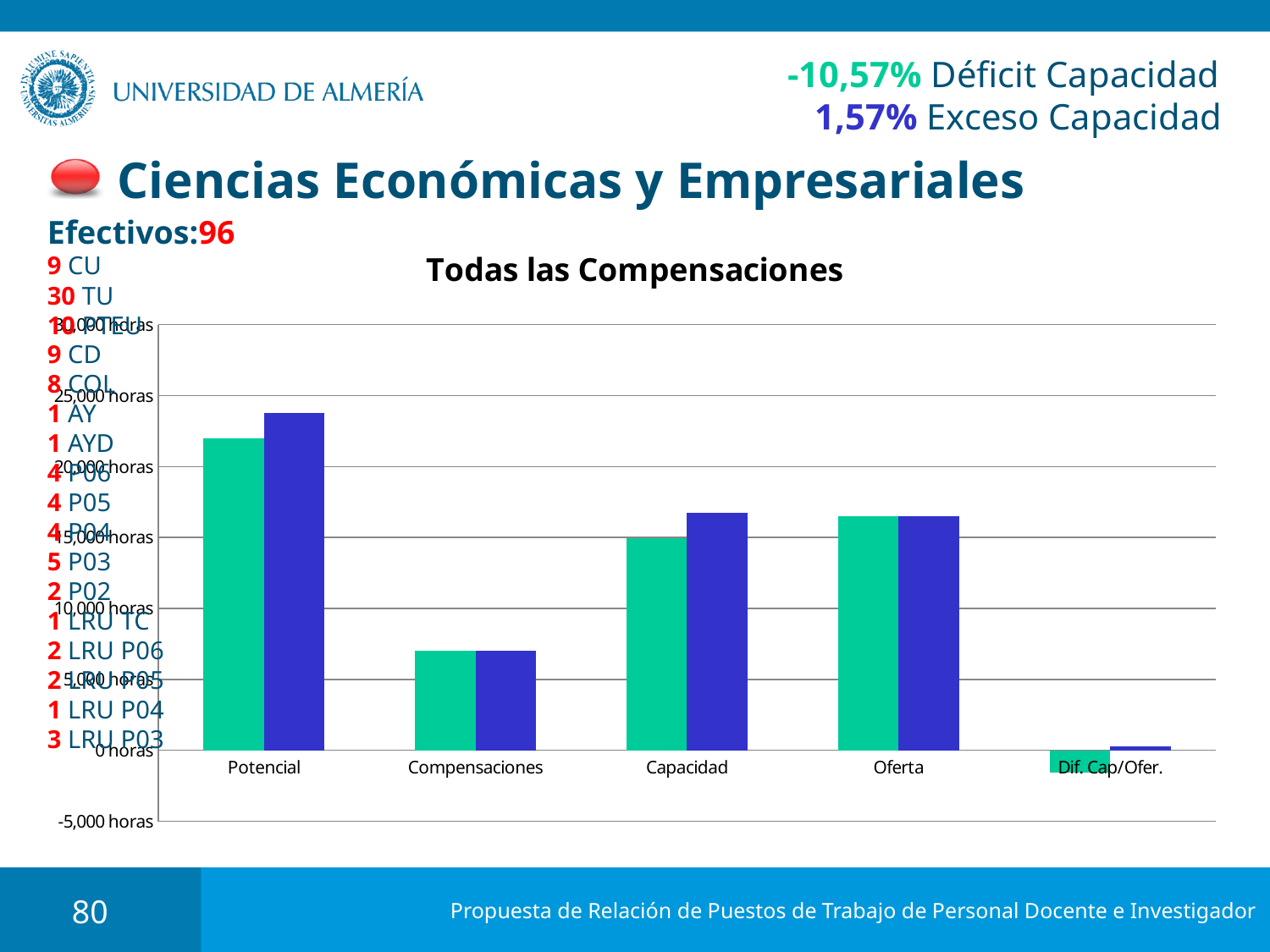
How many categories are shown on the x axis of the chart? 5 What is the title of the chart? Todas las Compensaciones Is the value of the green bar for Potencial greater or less than 20,000 horas? greater What kind of chart is shown under the title 'Todas las Compensaciones'? bar chart Which is larger, the green bar for Potencial or the green bar for Capacidad? Potencial What is the lowest value shown on the y axis of the chart? -5,000 horas Which category has the tallest bars in the chart? Potencial Which is larger, the blue bar for Compensaciones or the blue bar for Oferta? Oferta Is the value of the green bar for Compensaciones greater or less than 10,000 horas? less Which category has the lowest bars in the chart? Dif. Cap/Ofer. Is the value of the blue bar for Capacidad greater or less than 15,000 horas? greater